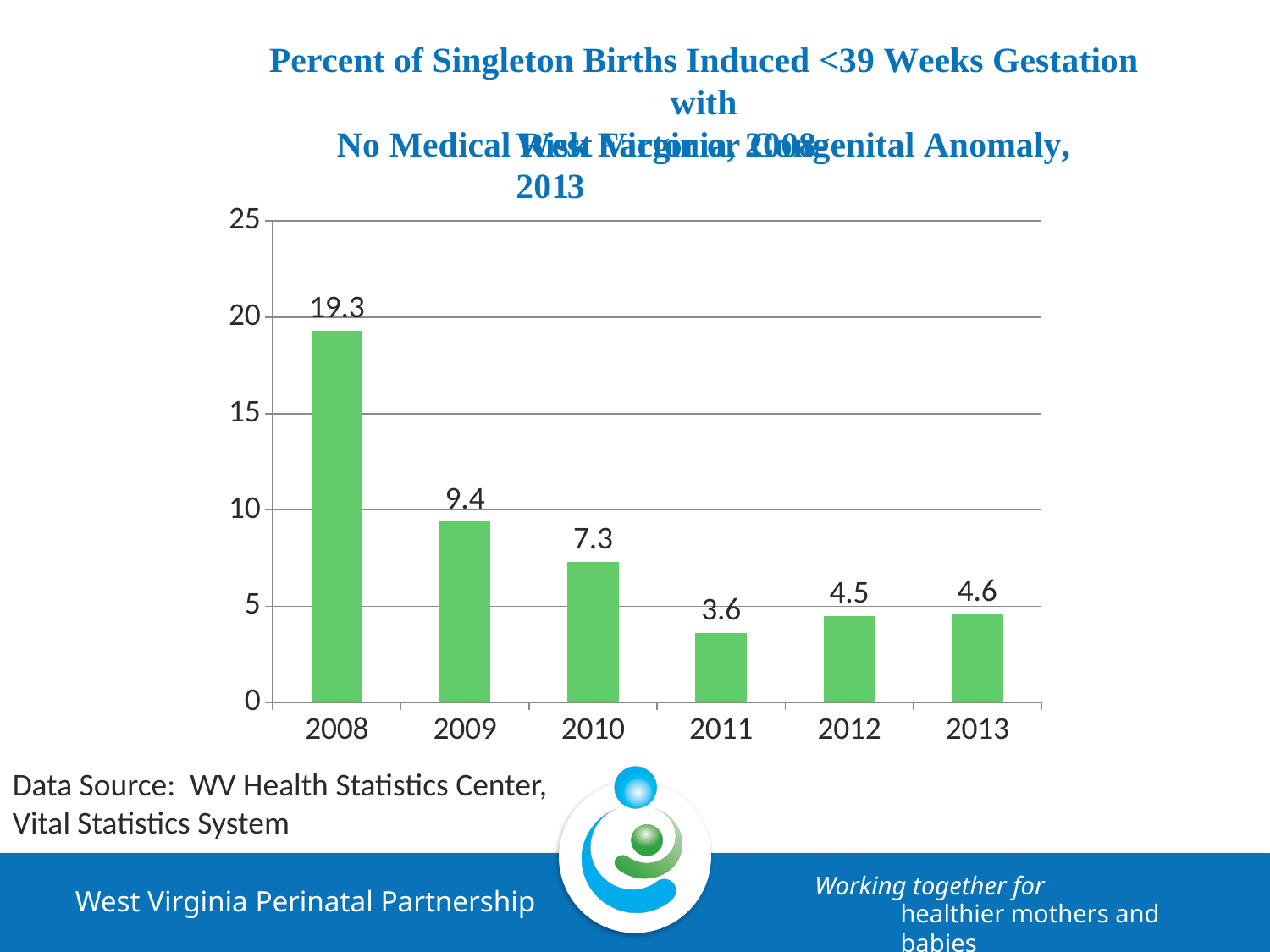
What is the difference between the values for 2008 and 2009? 9.9 Which year has the lowest value? 2011 Do the values generally rise or fall from 2008 to 2011? fall What kind of chart is shown on the slide? bar chart Is the value for 2012 greater or less than 5? less What is the value for 2008? 19.3 Which year has the highest value? 2008 How many years are shown on the x axis? 6 What is the value for 2011? 3.6 Which is larger, the value for 2009 or the value for 2010? 2009 What is the difference between the values for 2010 and 2011? 3.7 What is the value for 2013? 4.6